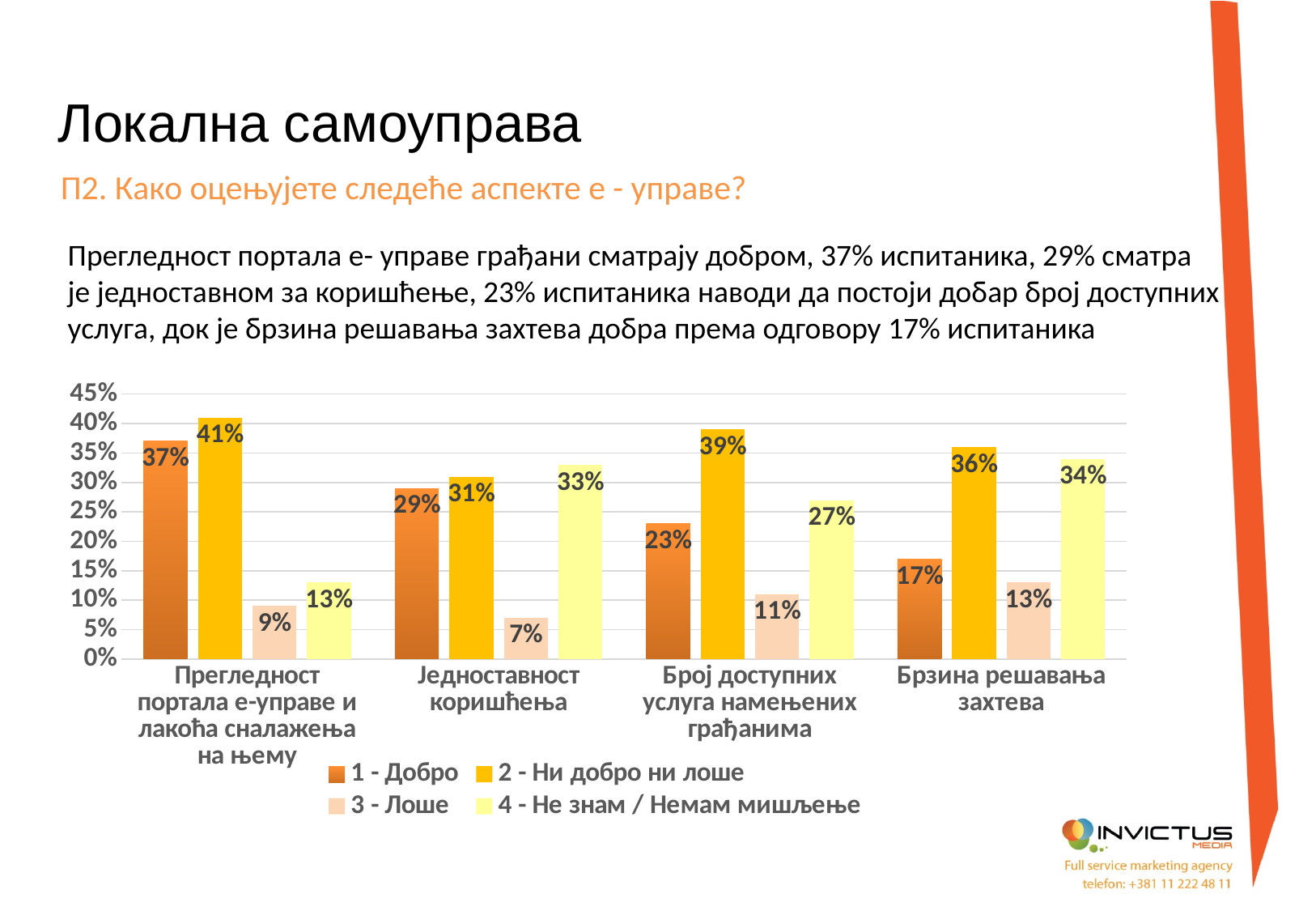
What is the difference between the "2 - Ни добро ни лоше" and "1 - Добро" values for "Брзина решавања захтева"? 19% Do the values for "1 - Добро" rise or fall from left to right across the categories? Fall Which is larger for "Једноставност коришћења": the value for "2 - Ни добро ни лоше" or for "4 - Не знам / Немам мишљење"? 4 - Не знам / Немам мишљење How many series does the legend list? 4 What is the value for "1 - Добро" in the category "Прегледност портала е-управе и лакоћа сналажења на њему"? 37% What is the value for "3 - Лоше" in the category "Једноставност коришћења"? 7% What kind of chart is shown on the slide? Bar chart Which category has the lowest value for "1 - Добро"? Брзина решавања захтева Which category has the highest value for "1 - Добро"? Прегледност портала е-управе и лакоћа сналажења на њему How many categories are shown on the x axis? 4 What is the value for "4 - Не знам / Немам мишљење" in the category "Брзина решавања захтева"? 34% What is the value for "2 - Ни добро ни лоше" in the category "Број доступних услуга намењених грађанима"? 39%